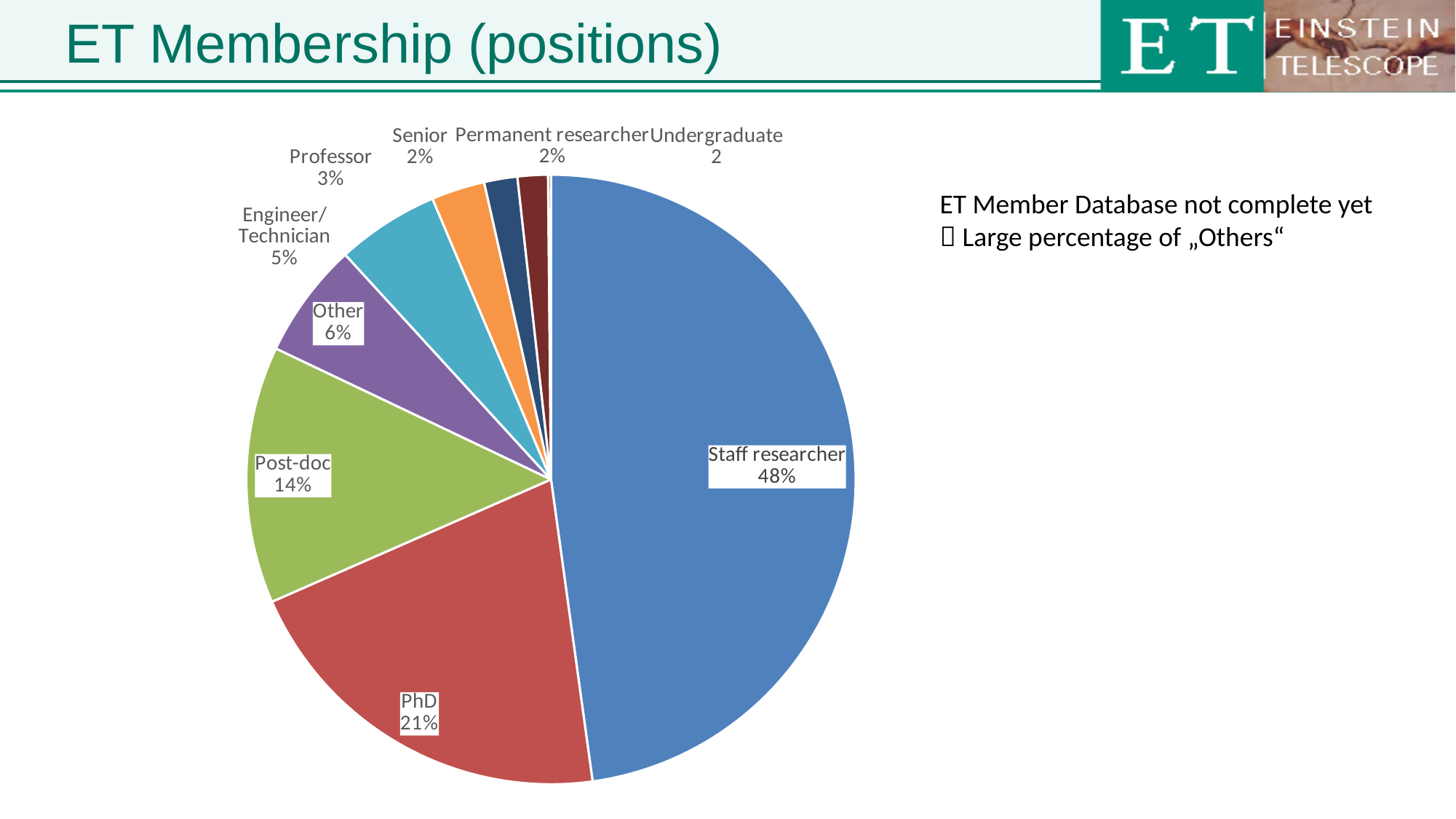
What share does Post-doc hold in the pie chart? 14% What percentage of the pie is PhD? 21% Which slice is larger, PhD or Post-doc? PhD What percentage is labelled for the Other slice? 6% What kind of chart is shown on the slide? pie chart What share of the pie is Engineer/Technician? 5% What share of ET membership is Staff researcher? 48% How many slices does the pie chart have? 9 How many percentage points larger is the Staff researcher share than the PhD share? 27 Which position has the largest share of the pie? Staff researcher What percentage of the pie is Professor? 3% What is the title of the slide containing the pie chart? ET Membership (positions)